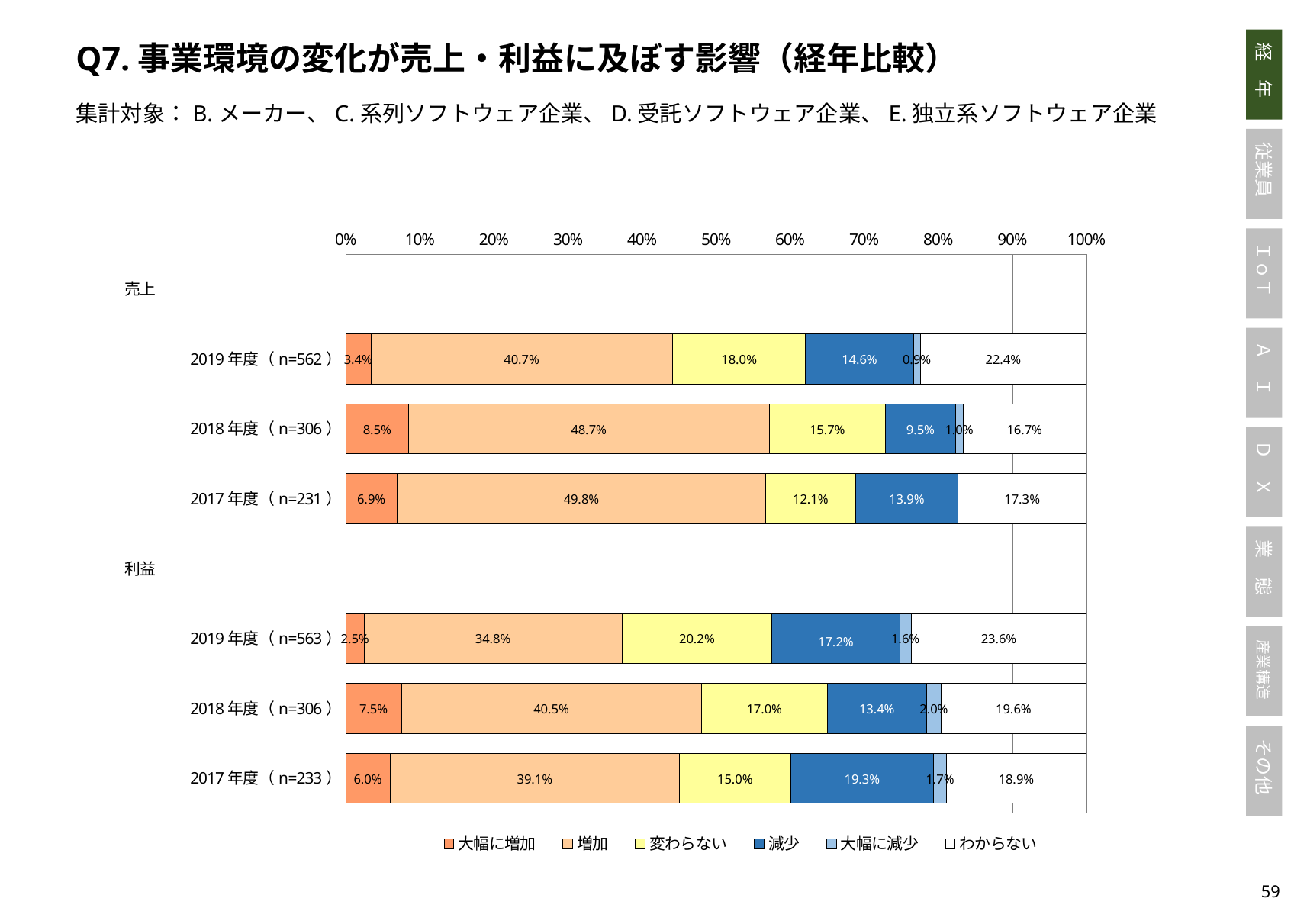
Among the three 利益 rows, which year has the lowest value for 大幅に増加? 2019年度 (n=563) How many year rows are plotted in the chart in total? 6 What is the difference between the 変わらない values for 利益 2019年度 (n=563) and 利益 2017年度 (n=233)? 5.2% How many series does the legend list? 6 What kind of chart is shown on the slide? stacked bar chart What is the value of 減少 for 利益 2017年度 (n=233)? 19.3% What is the value of わからない for 利益 2019年度 (n=563)? 23.6% Which is larger: 減少 for 売上 2019年度 (n=562) or 減少 for 売上 2018年度 (n=306)? 売上 2019年度 (n=562) Which legend entry is shown in yellow? 変わらない What is the value of 増加 for 売上 2019年度 (n=562)? 40.7% Among the three 売上 rows, which year has the highest value for 増加? 2017年度 (n=231) What is the value of 大幅に増加 for 売上 2018年度 (n=306)? 8.5%